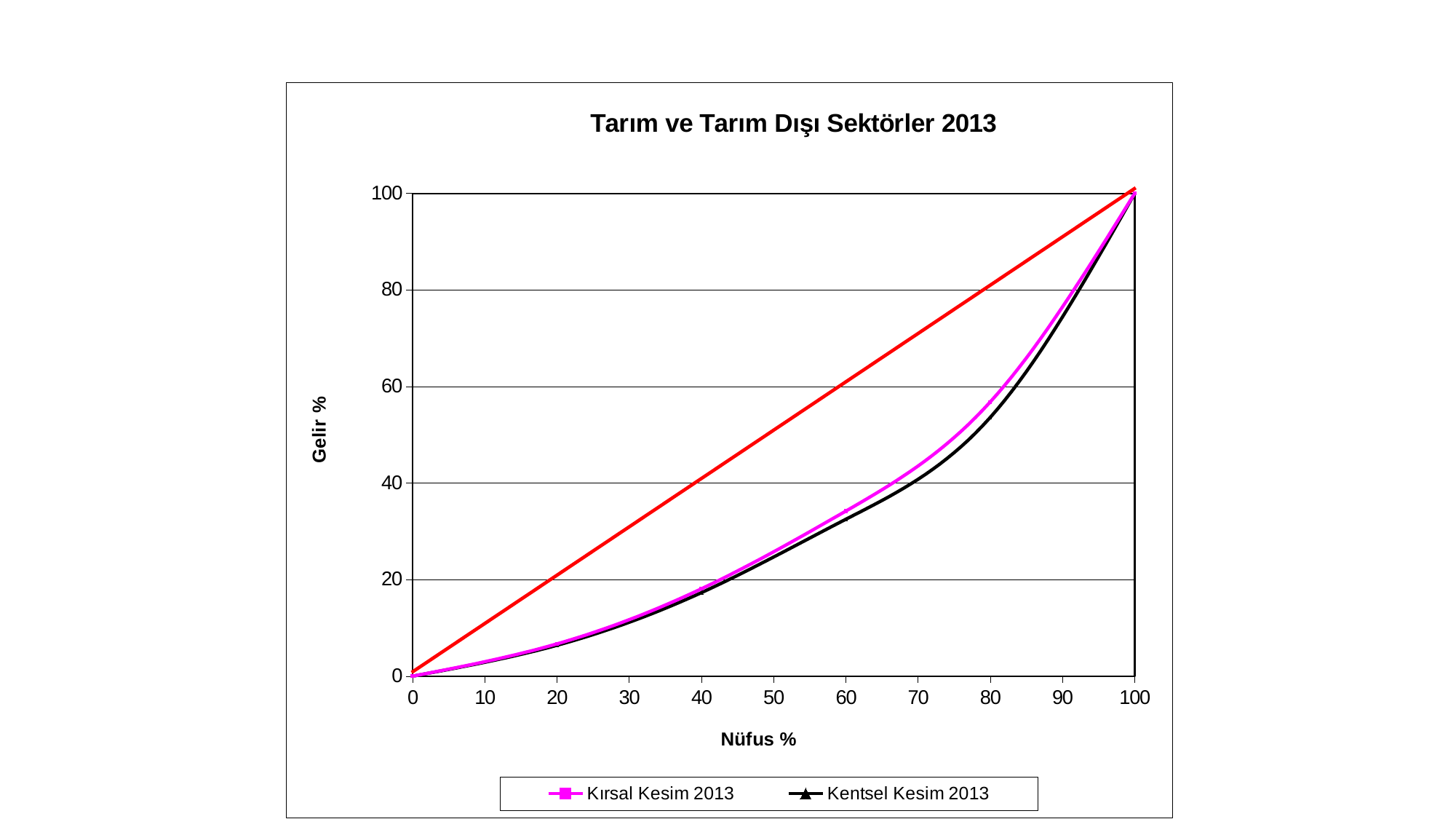
What is the title of the chart? Tarım ve Tarım Dışı Sektörler 2013 How many series does the legend list? 2 Do the values of Kentsel Kesim 2013 rise or fall as Nüfus % increases? rise At Nüfus % of 80, which series has the higher Gelir % value, Kırsal Kesim 2013 or Kentsel Kesim 2013? Kırsal Kesim 2013 What kind of chart is shown on the slide? line chart Is the Gelir % value for Kırsal Kesim 2013 at Nüfus % of 60 greater or less than 40? less What is the label of the vertical axis? Gelir % Is the Gelir % value for Kentsel Kesim 2013 at Nüfus % of 80 greater or less than 60? less Is the Gelir % value for Kentsel Kesim 2013 at Nüfus % of 20 greater or less than 20? less What is the Gelir % value for Kırsal Kesim 2013 at Nüfus % of 100? 100 What is the Gelir % value for Kentsel Kesim 2013 at Nüfus % of 0? 0